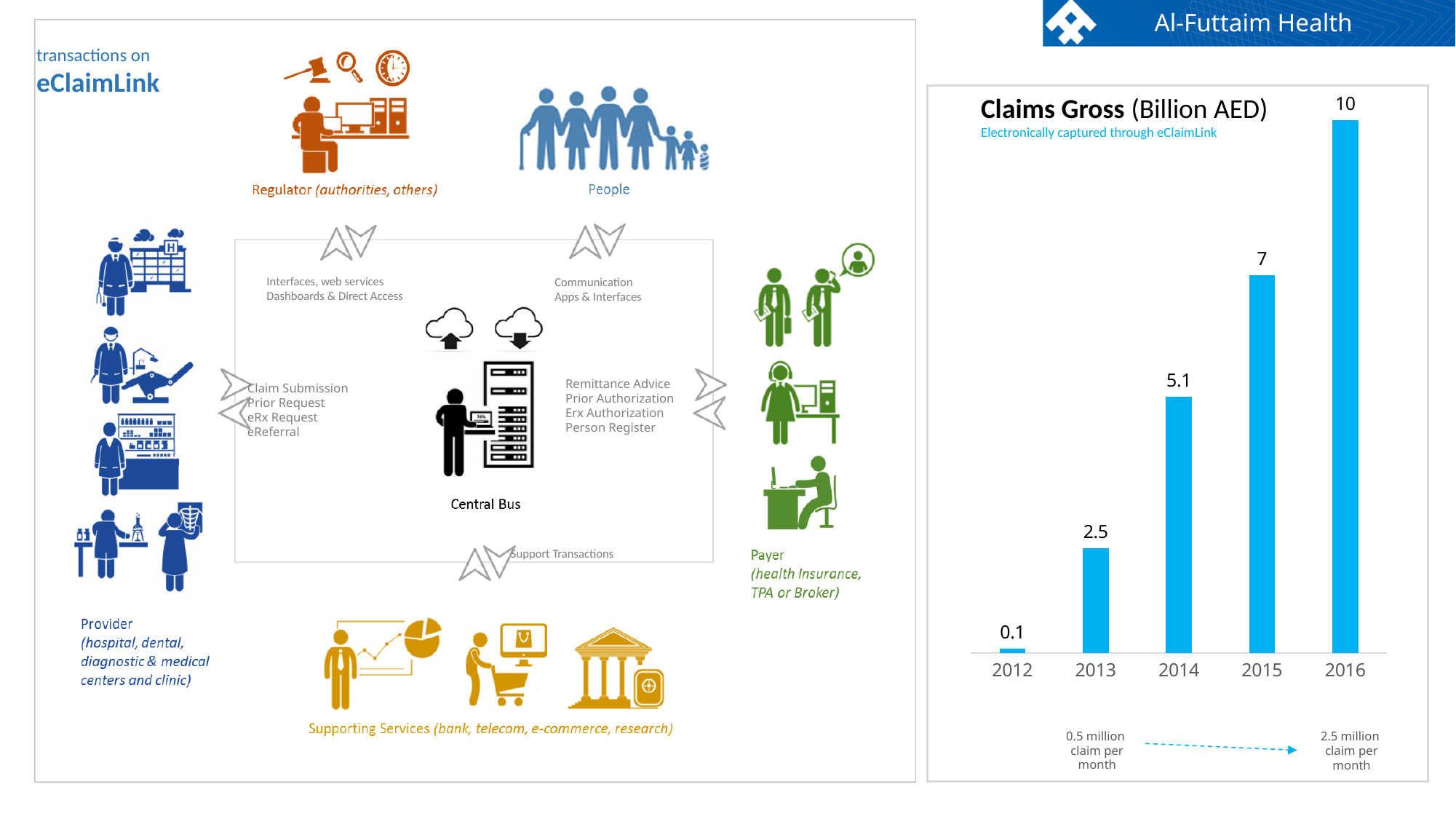
Which year has the highest Claims Gross value? 2016 What is the Claims Gross value for 2016? 10 What is the difference between the Claims Gross values for 2014 and 2013? 2.6 What kind of chart is the Claims Gross chart? bar chart What is the difference between the Claims Gross values for 2016 and 2015? 3 Which year has the lowest Claims Gross value? 2012 What is the Claims Gross value for 2014? 5.1 Do the Claims Gross values rise or fall from 2012 to 2016? rise Which is larger, the Claims Gross value for 2013 or for 2015? 2015 What is the Claims Gross value for 2012? 0.1 How many years are shown in the Claims Gross chart? 5 In what unit are the Claims Gross values expressed, according to the chart title? Billion AED